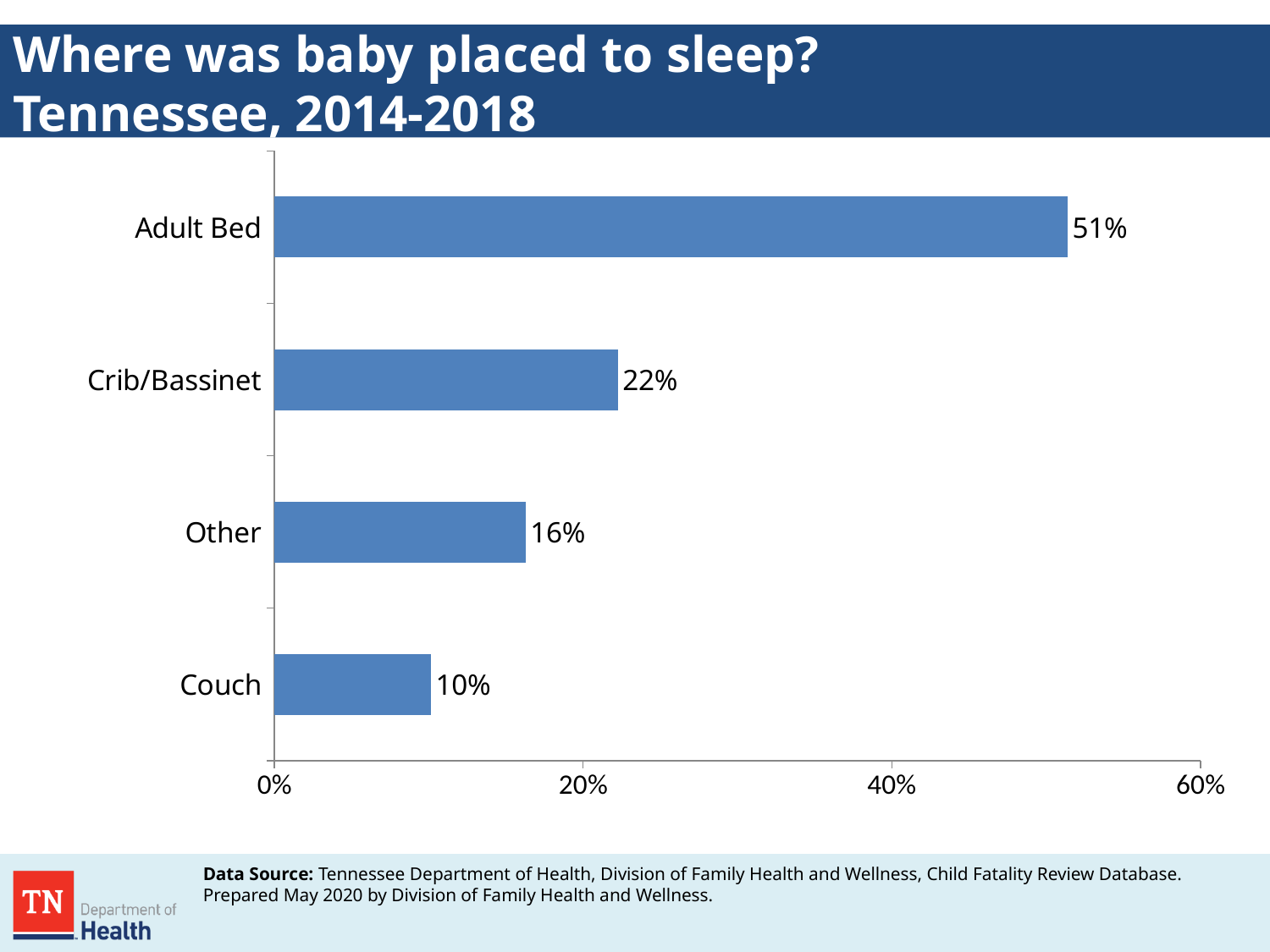
What is the difference in percentage points between Other and Couch? 6 Which sleep location has the lowest percentage? Couch What type of chart is shown on the slide? Bar chart What is the value shown for Other? 16% Which sleep location has the highest percentage? Adult Bed What percentage of babies were placed to sleep in an Adult Bed? 51% What is the difference in percentage points between Adult Bed and Crib/Bassinet? 29 Is the value for Adult Bed greater or less than 40%? greater Which is larger, the value for Crib/Bassinet or the value for Other? Crib/Bassinet What is the value shown for Couch? 10% What is the value shown for Crib/Bassinet? 22% How many sleep location categories are shown in the chart? 4